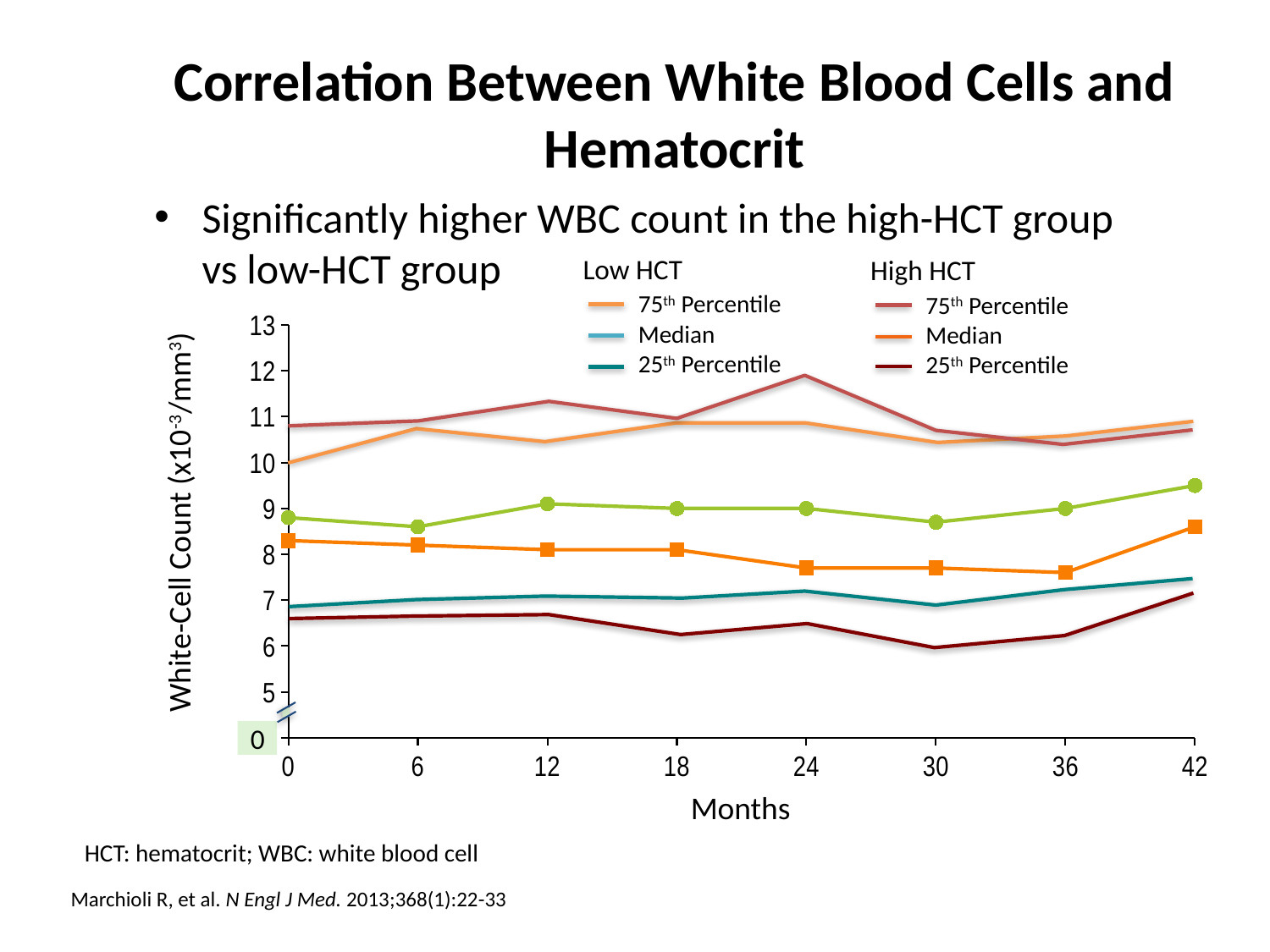
Is the value of the dark red line at 0 months greater or less than 7? less Is the value of the orange line with square markers at 36 months greater or less than 8? less What is the title of the x axis? Months At which month does the green line with circle markers reach its highest value? 42 How many time points are plotted along the Months axis? 8 Is the value of the orange line with square markers at 0 months greater or less than 8? greater At 42 months, which is higher: the green line with circle markers or the orange line with square markers? The green line with circle markers What kind of chart is shown on the slide? Line chart Does the orange line with square markers rise or fall from 0 to 36 months? Fall How many series does the legend list in total? 6 What are the two groups named in the legend? Low HCT and High HCT